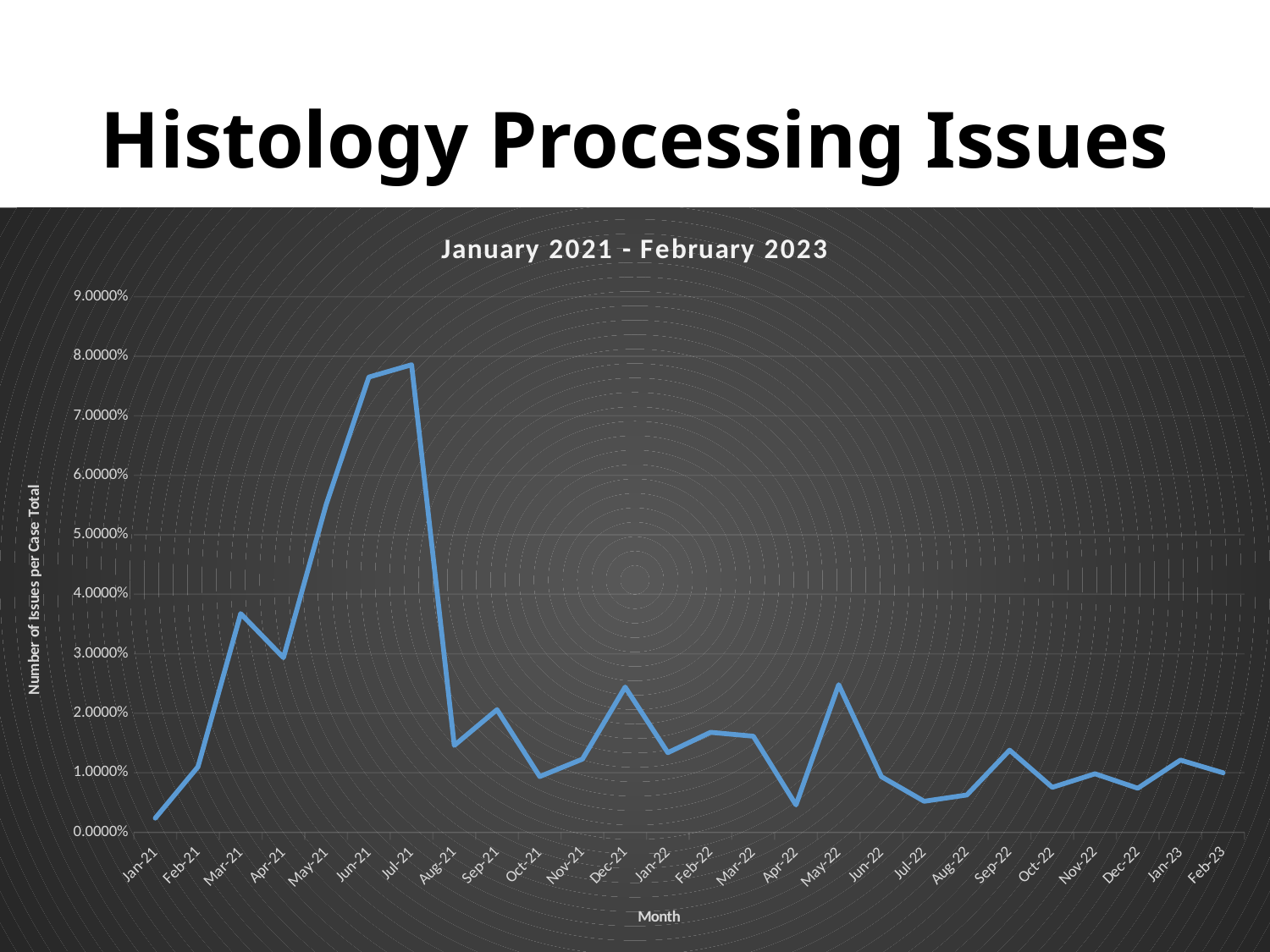
Which month has the lowest value? Jan-21 What kind of chart is shown on the slide? line chart How many months are plotted along the x axis? 26 Is the value for Jul-21 greater or less than 7.0000%? greater Is the value for Apr-22 greater or less than 1.0000%? less What is the title of the chart? January 2021 - February 2023 Is the value for Jan-21 greater or less than 1.0000%? less Do the values rise or fall from Jan-21 to Jul-21? rise Which is higher, the value for Mar-21 or the value for Apr-21? Mar-21 Which month has the highest value? Jul-21 What is the label of the vertical axis? Number of Issues per Case Total